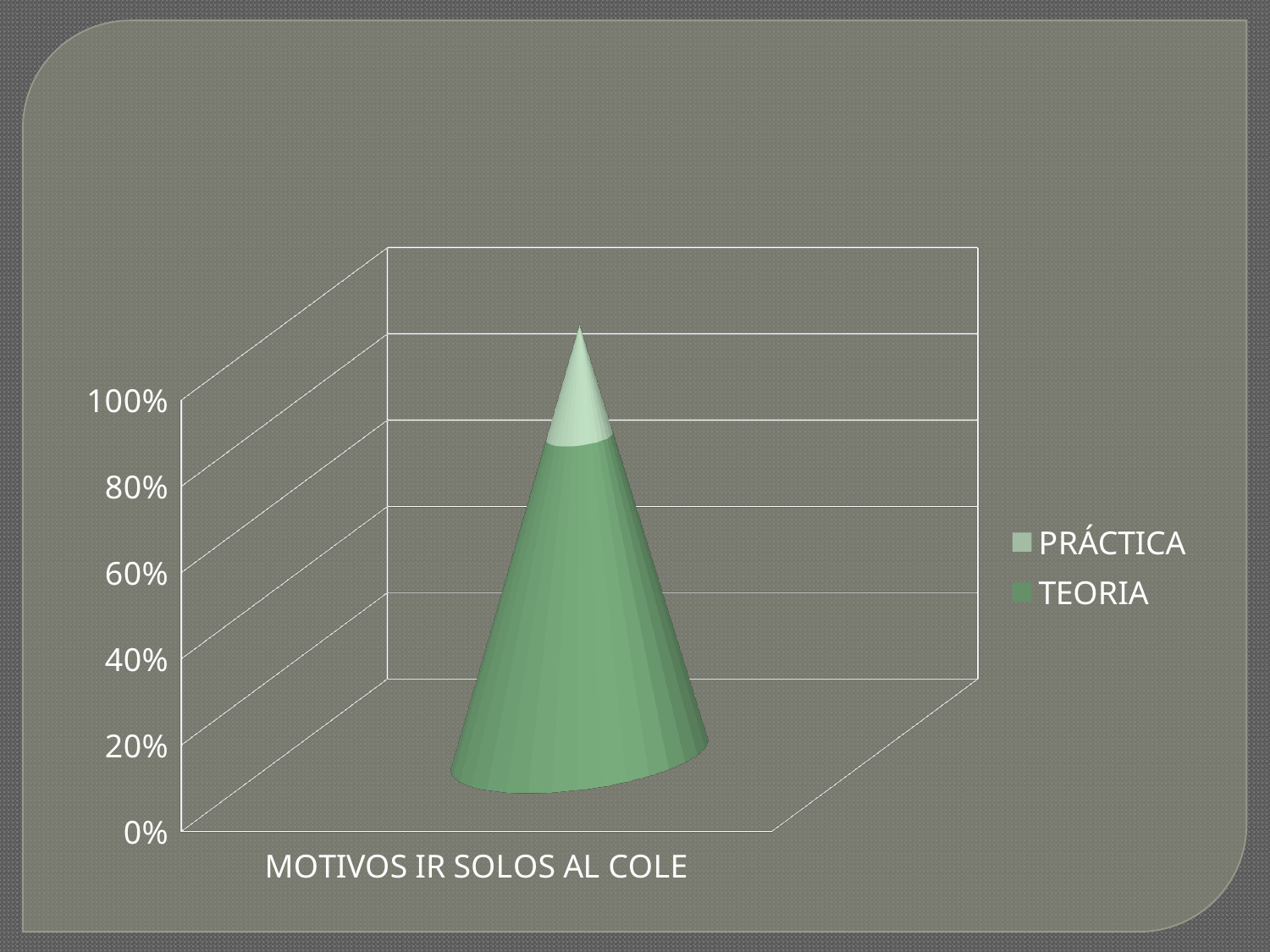
How many series does the legend list? 2 What is the category label shown on the x axis? MOTIVOS IR SOLOS AL COLE What kind of chart is shown on the slide? bar chart Which series are listed in the legend? PRÁCTICA and TEORIA Is the value for PRÁCTICA greater or less than 40%? less Which series takes up the larger part of the bar for MOTIVOS IR SOLOS AL COLE, PRÁCTICA or TEORIA? TEORIA What is the highest value shown on the vertical axis? 100% Which series has the largest share of the bar? TEORIA Is the value for TEORIA greater or less than 60%? greater Which series has the smallest share of the bar? PRÁCTICA How many categories are shown on the x axis? 1